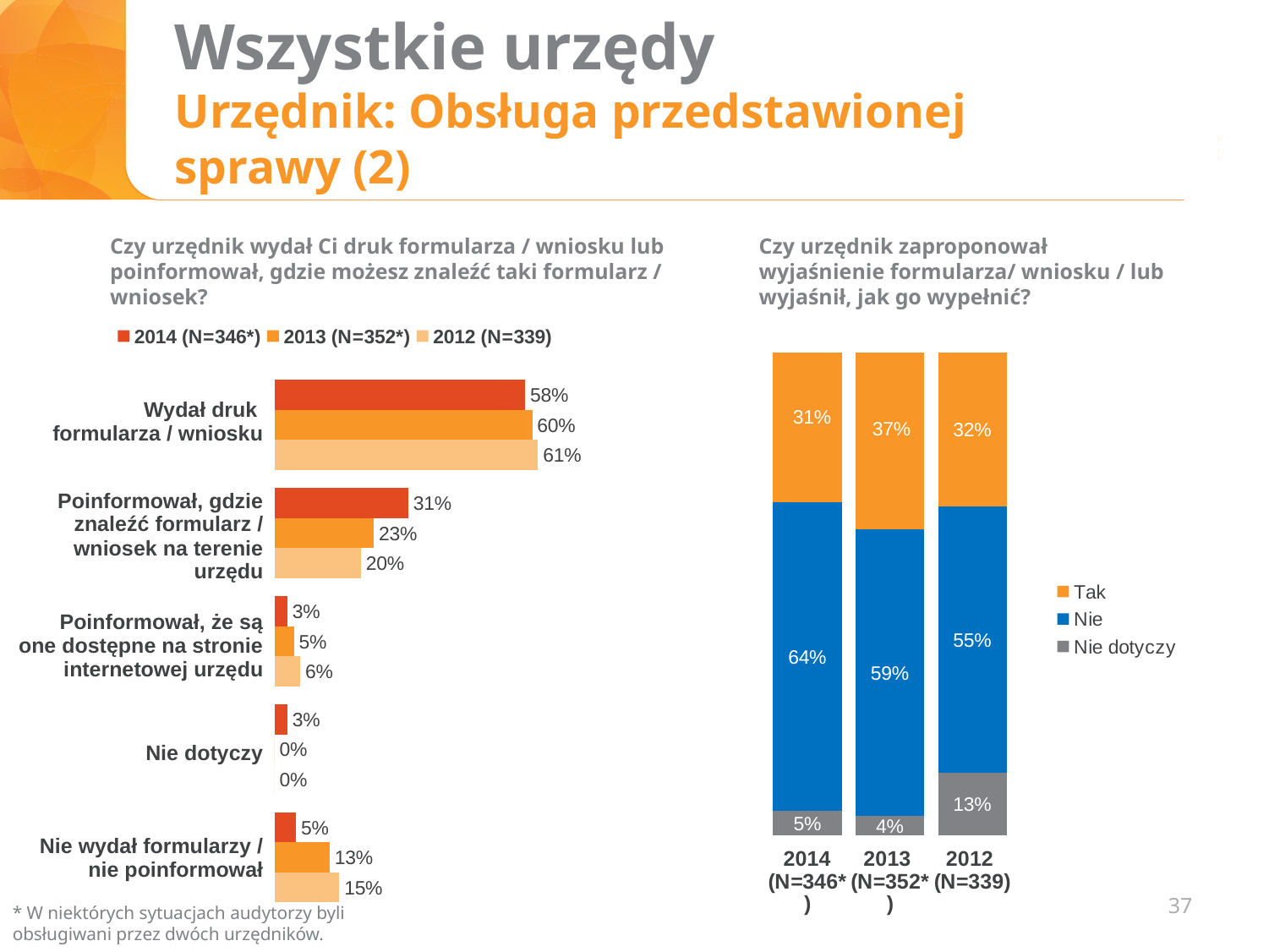
In the left chart, which category has the highest 2014 value? Wydał druk formularza / wniosku In the left chart, what is the 2012 value for "Poinformował, gdzie znaleźć formularz / wniosek na terenie urzędu"? 20% In the left chart, what is the difference between the 2014 and 2013 values for "Poinformował, gdzie znaleźć formularz / wniosek na terenie urzędu"? 8 percentage points In the right chart, what is the "Nie dotyczy" value for 2012? 13% In the right chart, what is the "Nie" value for 2013? 59% In the left chart, what is the 2013 value for "Nie wydał formularzy / nie poinformował"? 13% What kind of chart is the left chart? Bar chart In the right chart, which year has the highest "Tak" value? 2013 In the left chart, how many categories are shown? 5 In the left chart, what is the 2014 value for "Wydał druk formularza / wniosku"? 58% In the right chart, what is the total of the 2014 stacked bar? 100% In the left chart, how many series does the legend list? 3